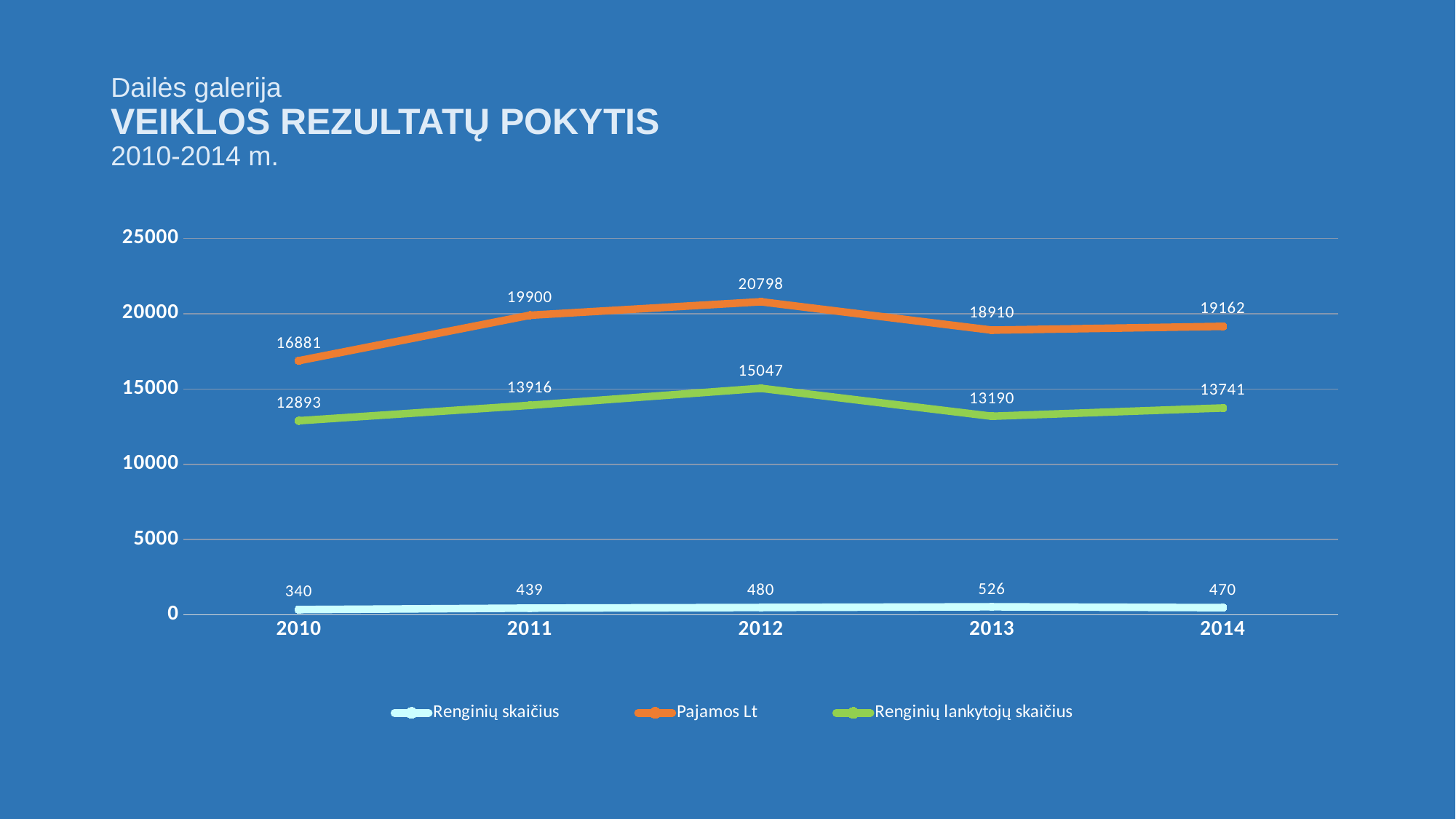
How many series does the legend list? 3 What kind of chart is shown on the slide? line chart What is the difference between Pajamos Lt in 2012 and in 2013? 1888 Is the value of Pajamos Lt in 2010 greater or less than 15000? greater Which is larger: Renginių lankytojų skaičius in 2011 or in 2014? 2011 What is the value of Renginių lankytojų skaičius in 2010? 12893 What is the value of Pajamos Lt in 2012? 20798 How many years are shown on the x axis? 5 In which year is Renginių skaičius lowest? 2010 What is the value of Renginių skaičius in 2013? 526 Does Renginių skaičius rise or fall from 2010 to 2013? rise In which year is Pajamos Lt highest? 2012